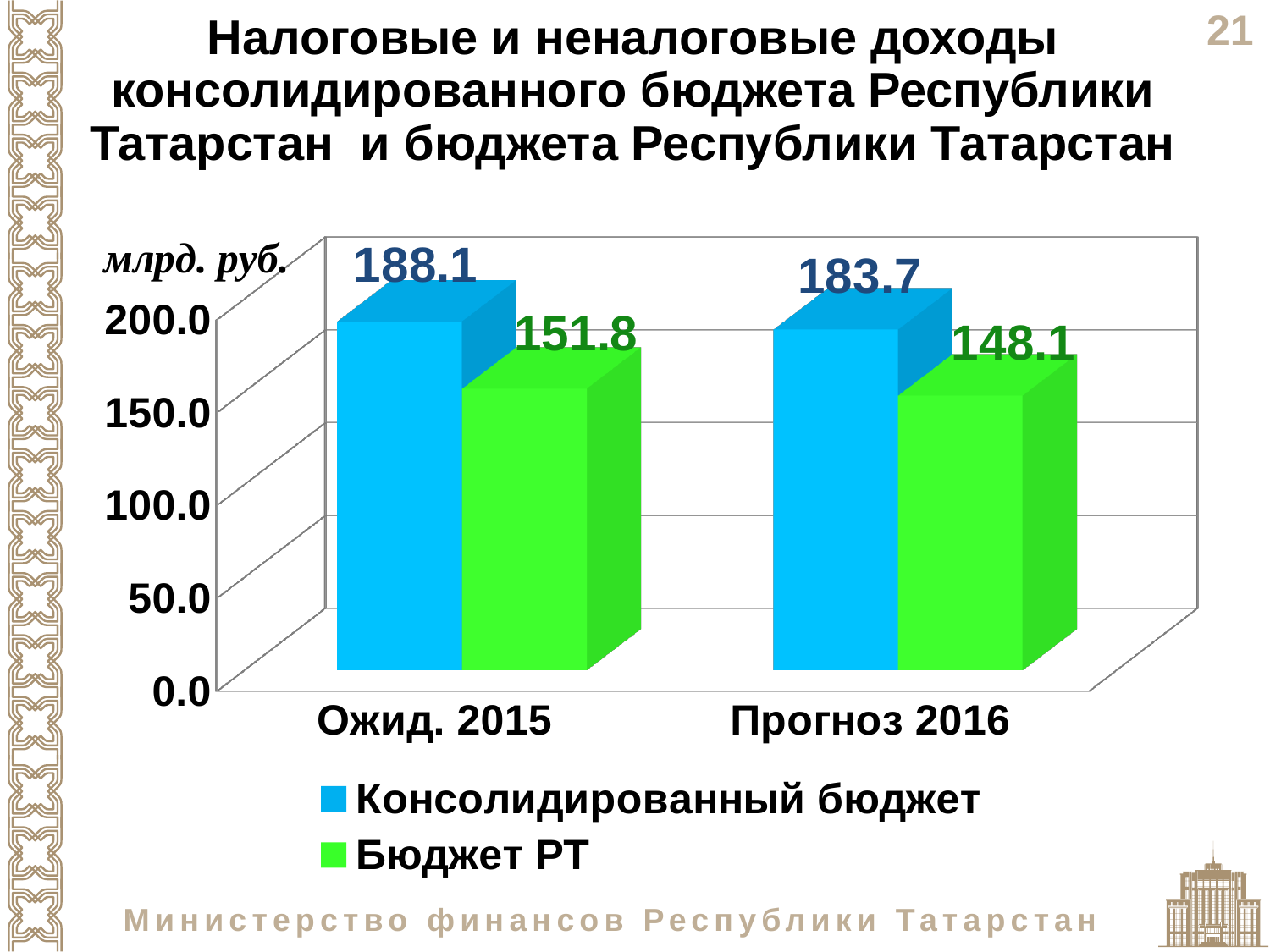
What kind of chart is shown on the slide? Bar chart What unit is shown on the chart's axis label? млрд. руб. What is the difference between Консолидированный бюджет and Бюджет РТ in Ожид. 2015? 36.3 How many series does the legend list? 2 What is the difference between the Консолидированный бюджет values for Ожид. 2015 and Прогноз 2016? 4.4 Which category has the highest value for Консолидированный бюджет? Ожид. 2015 Which is larger in Прогноз 2016: Консолидированный бюджет or Бюджет РТ? Консолидированный бюджет What is the value for Консолидированный бюджет in Ожид. 2015? 188.1 What is the value for Бюджет РТ in Ожид. 2015? 151.8 What is the value for Консолидированный бюджет in Прогноз 2016? 183.7 What is the value for Бюджет РТ in Прогноз 2016? 148.1 Which category has the lowest value for Бюджет РТ? Прогноз 2016